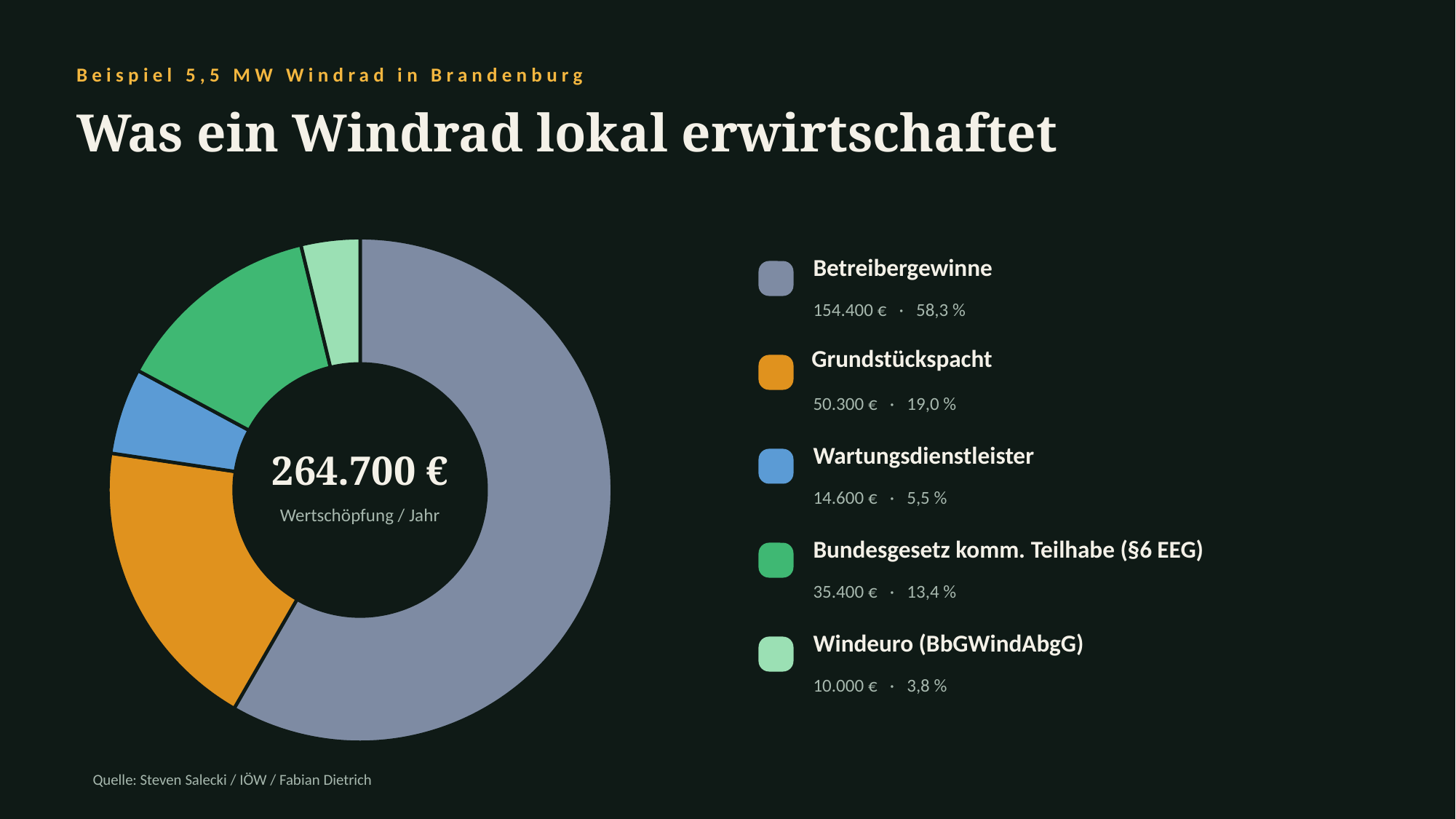
What is the difference in value between Grundstückspacht and Wartungsdienstleister? 35.700 € What total value is shown in the centre of the chart? 264.700 € What share of the pie does Bundesgesetz komm. Teilhabe (§6 EEG) represent? 13,4 % What is the value for Wartungsdienstleister? 14.600 € What is the value for Windeuro (BbGWindAbgG)? 10.000 € What kind of chart is shown on the slide? Doughnut chart What is the value for Betreibergewinne? 154.400 € Which is larger, Bundesgesetz komm. Teilhabe (§6 EEG) or Wartungsdienstleister? Bundesgesetz komm. Teilhabe (§6 EEG) What share of the pie does Grundstückspacht represent? 19,0 % Which category has the largest share of the pie? Betreibergewinne How many categories does the chart show? 5 Which category has the smallest share of the pie? Windeuro (BbGWindAbgG)